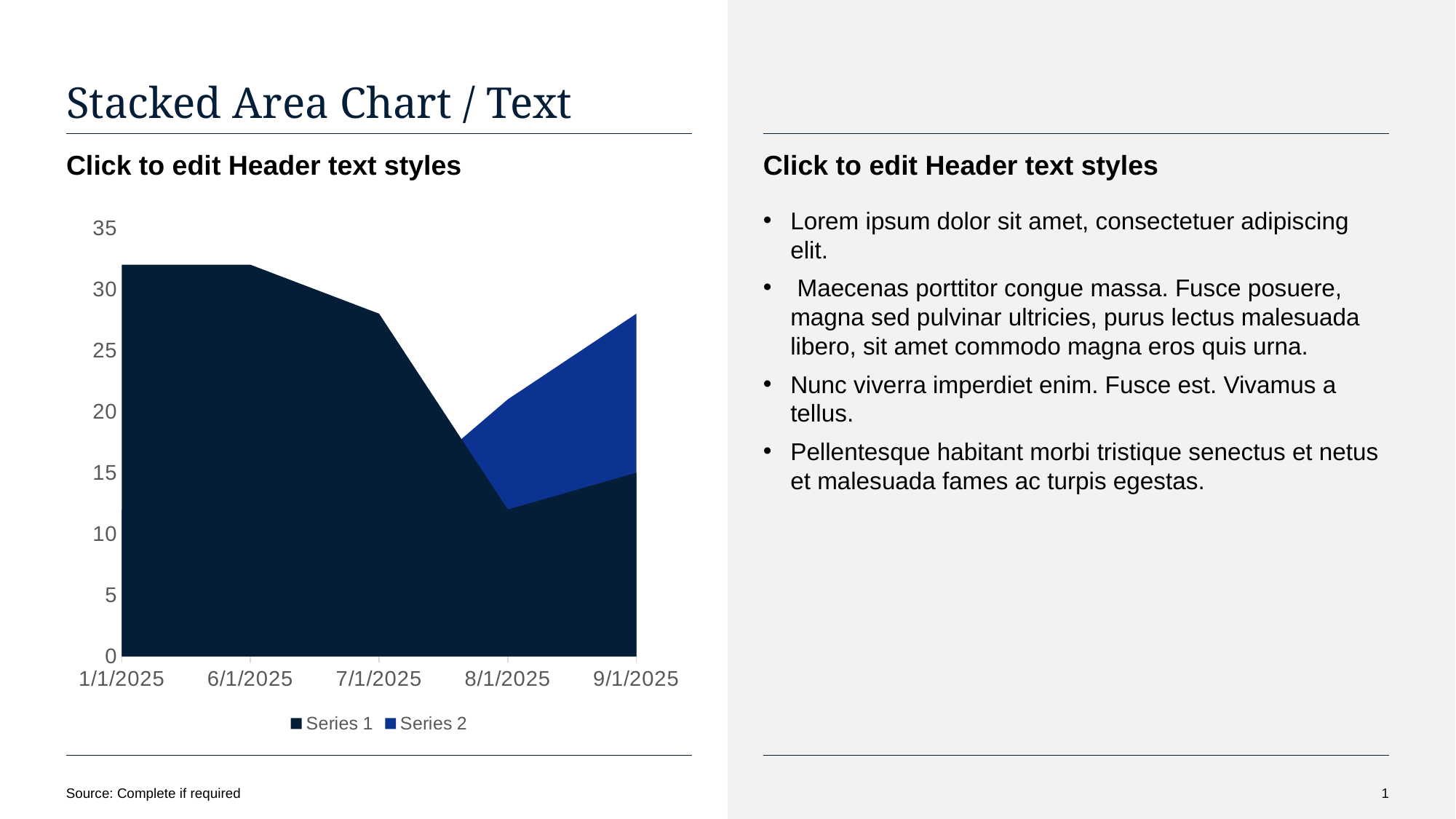
Is the stacked total at 9/1/2025 greater or less than 25? greater How many dates are shown on the x axis of the chart? 5 At which date is Series 1 at its lowest? 8/1/2025 Is the value for Series 1 at 1/1/2025 greater or less than 30? greater What kind of chart is shown on the slide? Stacked area chart Is the value for Series 1 at 9/1/2025 greater or less than 20? less How many series does the chart legend list? 2 Does Series 1 rise or fall from 6/1/2025 to 8/1/2025? Fall What are the two entries in the chart legend? Series 1 and Series 2 Which is larger for Series 1: the value at 7/1/2025 or at 8/1/2025? 7/1/2025